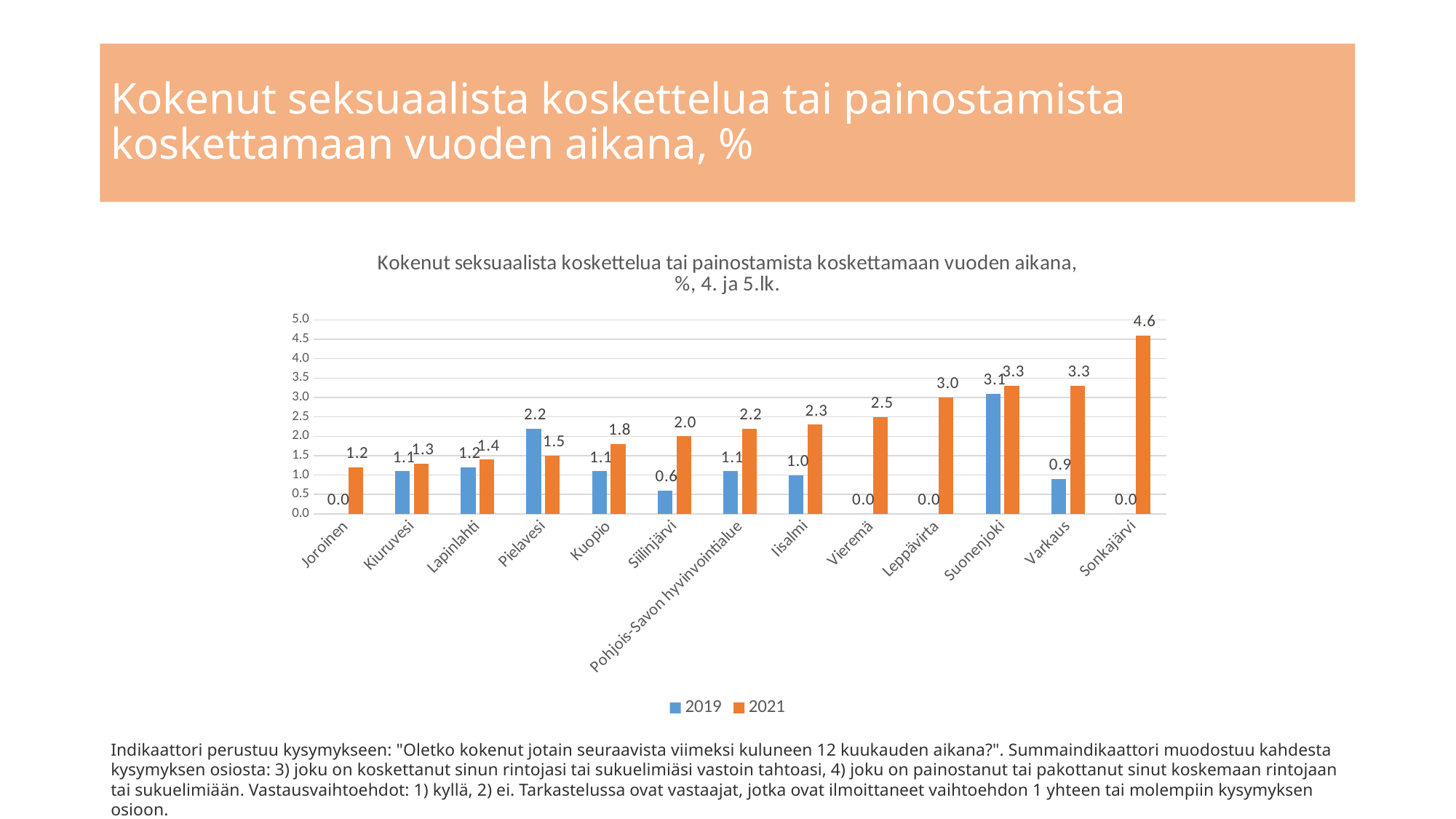
What is the difference between the 2021 and 2019 values for Siilinjärvi? 1.4 How many series does the legend list? 2 Which category has the highest 2019 value? Suonenjoki Which category has the lowest 2021 value? Joroinen Which is larger for Pielavesi, the 2019 value or the 2021 value? 2019 What is the 2019 value for Pielavesi? 2.2 What is the 2021 value for Pohjois-Savon hyvinvointialue? 2.2 What is the 2021 value for Sonkajärvi? 4.6 What kind of chart is shown on the slide? Bar chart Which category has the highest 2021 value? Sonkajärvi Do the 2021 values generally rise or fall from left to right along the x axis? Rise How many categories are shown on the x axis? 13